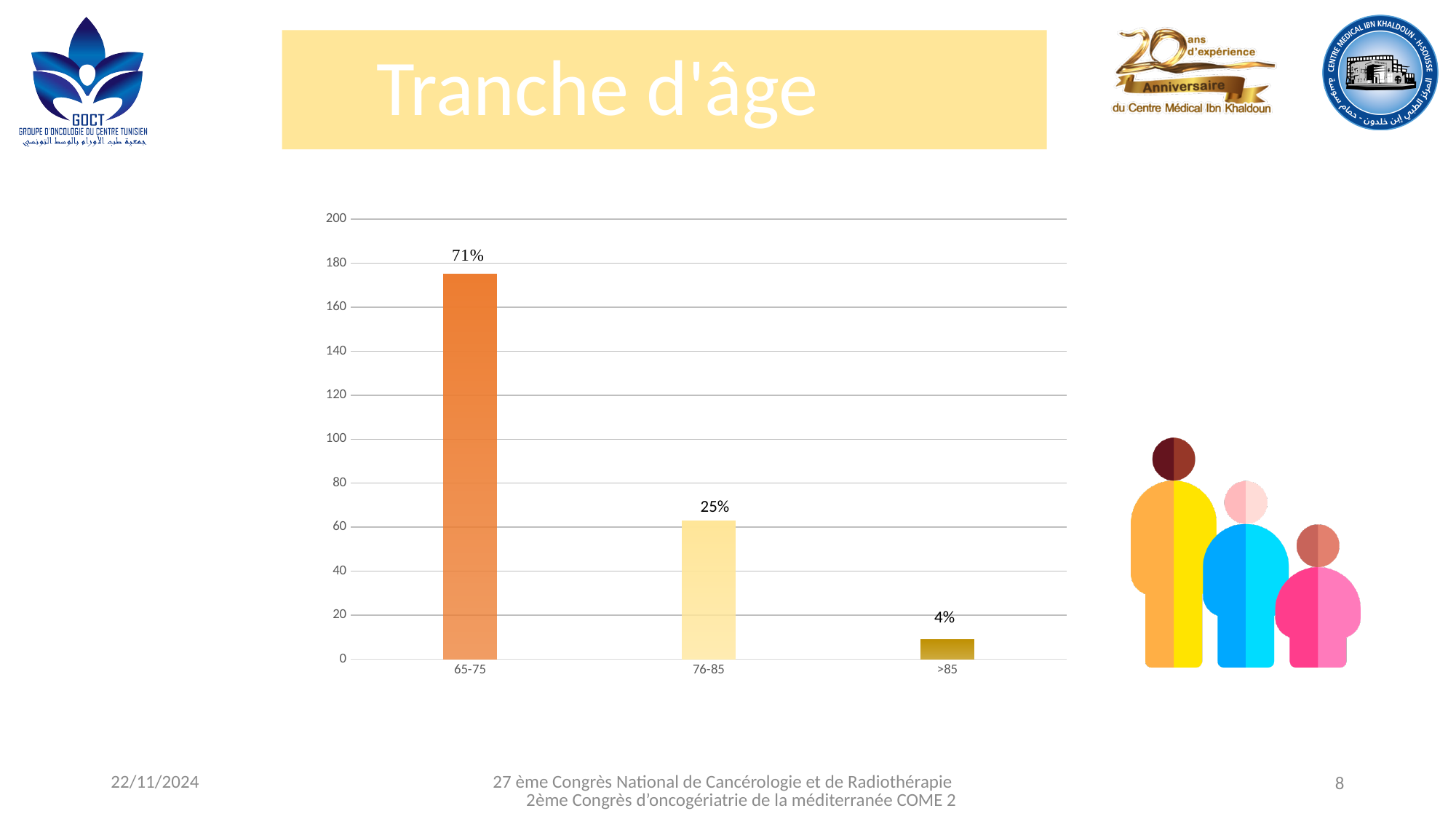
What is the title shown above the chart on the slide? Tranche d'âge How many age categories are plotted on the chart? 3 Which age group has the lowest bar? >85 What percentage label is shown for the >85 age group? 4% Is the value for 65-75 greater or less than 160 on the axis? greater What percentage label is shown for the 76-85 age group? 25% What is the difference between the percentage labels for 65-75 and 76-85? 46% What percentage label is shown for the 65-75 age group? 71% What kind of chart is shown on the slide? bar chart Is the value for >85 greater or less than 20 on the axis? less Which is larger, the bar for 76-85 or the bar for >85? 76-85 Which age group has the highest bar? 65-75